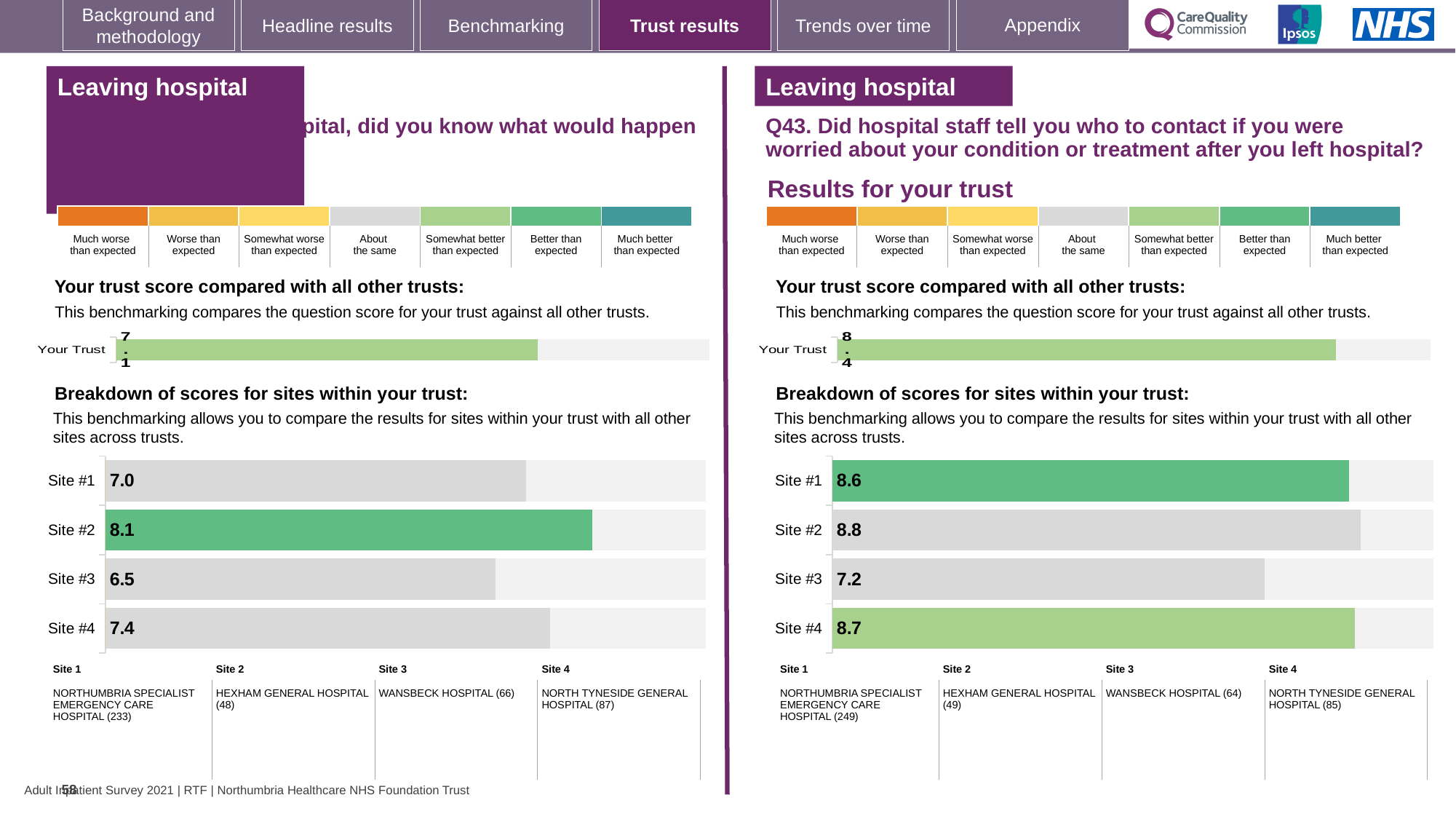
On the right-hand (Q43) site breakdown chart, which has the higher score, Site #1 or Site #3? Site #1 On the left-hand site breakdown chart, which has the higher score, Site #4 or Site #1? Site #4 On the right-hand (Q43) site breakdown chart, what is the score for Site #2? 8.8 On the left-hand site breakdown chart, which site has the highest score? Site #2 What type of chart is used for the site breakdown on the right-hand (Q43) side of the slide? Bar chart What is the 'Your Trust' score shown on the left-hand trust comparison chart? 7.1 On the right-hand (Q43) site breakdown chart, what is the difference between the scores for Site #2 and Site #3? 1.6 On the left-hand site breakdown chart, what is the difference between the scores for Site #2 and Site #3? 1.6 What is the 'Your Trust' score shown on the right-hand (Q43) trust comparison chart? 8.4 On the left-hand site breakdown chart, what is the score for Site #3? 6.5 How many sites are shown on the right-hand (Q43) site breakdown chart? 4 On the right-hand (Q43) site breakdown chart, which site has the lowest score? Site #3